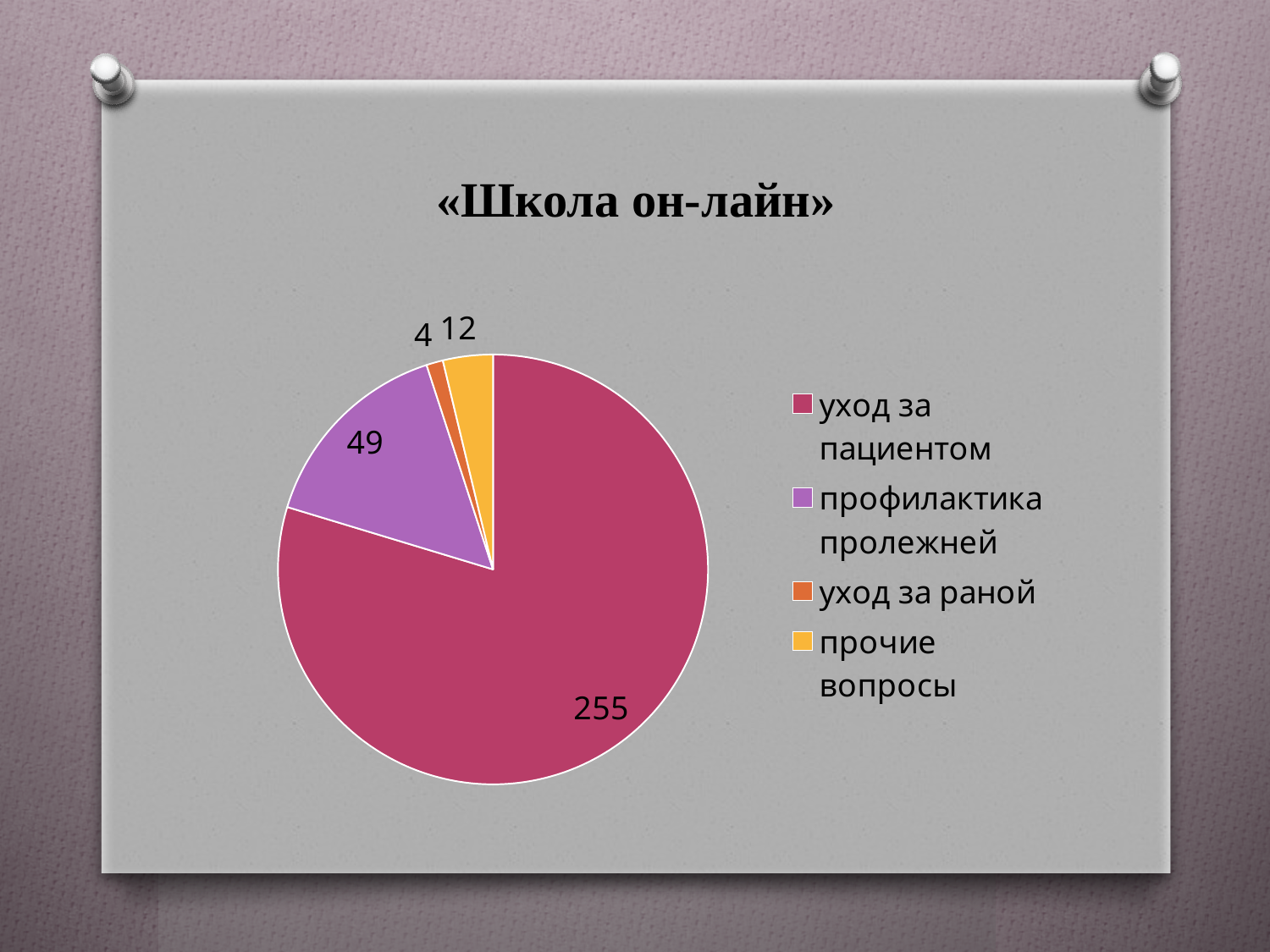
Which category has the largest slice of the pie? уход за пациентом What type of chart is shown on the slide? pie chart What is the value for «прочие вопросы»? 12 What is the value for «уход за раной»? 4 What is the difference between the values for «уход за пациентом» and «профилактика пролежней»? 206 What is the value for «профилактика пролежней»? 49 What is the total of all slices in the pie chart? 320 What is the value for «уход за пациентом»? 255 Which category has the smallest slice of the pie? уход за раной Which is larger: «прочие вопросы» or «уход за раной»? прочие вопросы How many categories does the pie chart have? 4 What is the title of the chart? «Школа он-лайн»